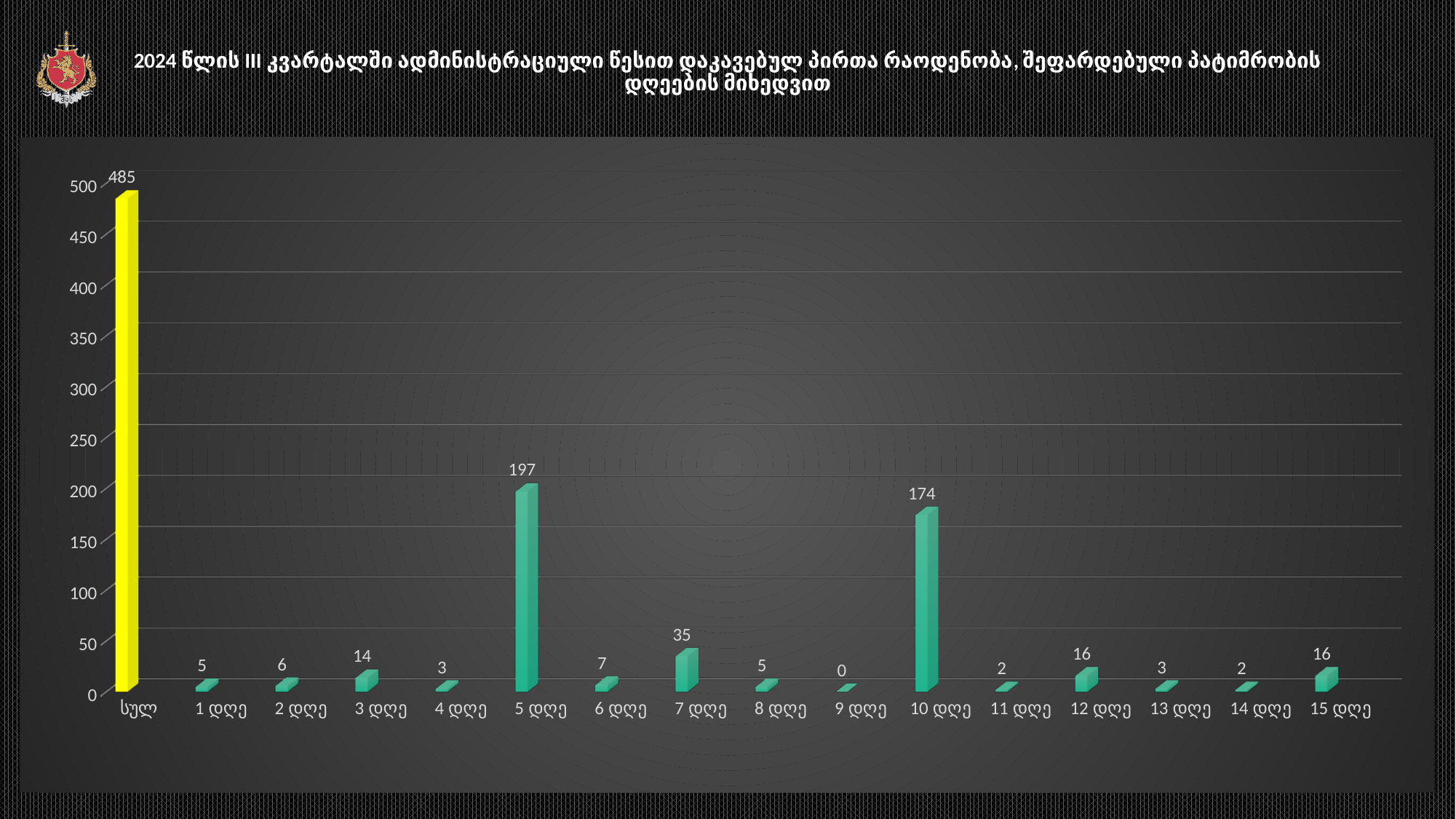
Which is larger, the value for "3 დღე" or the value for "12 დღე"? 12 დღე What is the value for "7 დღე"? 35 What is the value for "10 დღე"? 174 Excluding the "სულ" total bar, which day category has the highest value? 5 დღე Which category has the lowest value? 9 დღე What is the difference between the values for "5 დღე" and "10 დღე"? 23 How many categories are shown on the x axis? 16 What colour is the "სულ" bar? Yellow What is the value for the "სულ" bar? 485 What is the value for "9 დღე"? 0 What kind of chart is shown on the slide? Bar chart What is the value for "5 დღე"? 197